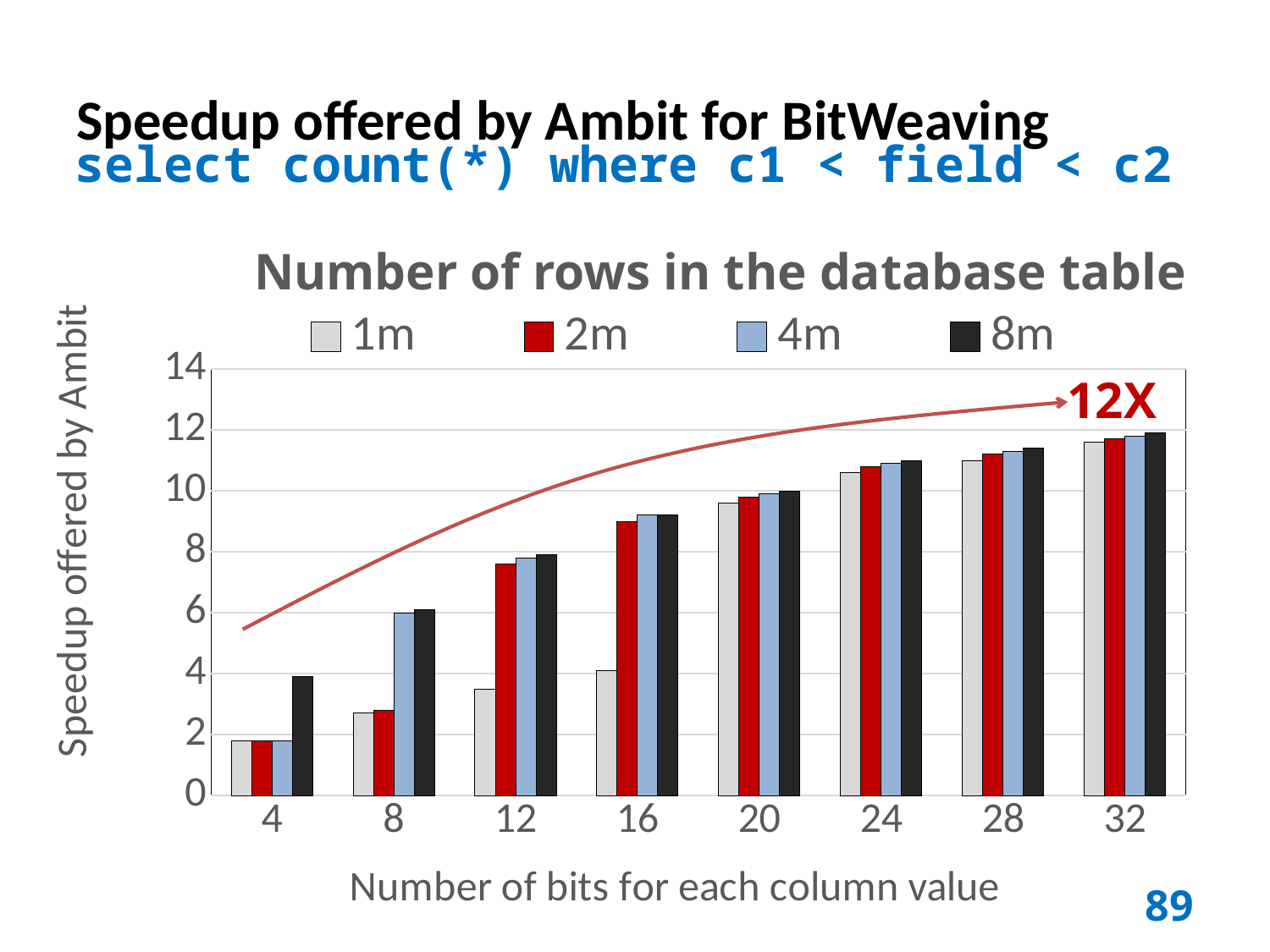
At 4 bits, which series has the highest speedup? 8m What annotation is written in red at the end of the arrow on the chart? 12X Is the speedup for 1m rows at 12 bits greater or less than 4? less Is the speedup for 1m rows at 32 bits greater or less than 12? less At 16 bits, which series has the lowest speedup? 1m What kind of chart is shown on the slide? bar chart Which is larger: the speedup for 8m rows at 8 bits or the speedup for 1m rows at 12 bits? 8m rows at 8 bits How many series does the legend list? 4 Is the speedup for 2m rows at 16 bits greater or less than 8? greater Do the speedup values rise or fall as the number of bits for each column value increases? rise How many categories (numbers of bits) are shown on the x axis? 8 What is the title shown above the legend? Number of rows in the database table